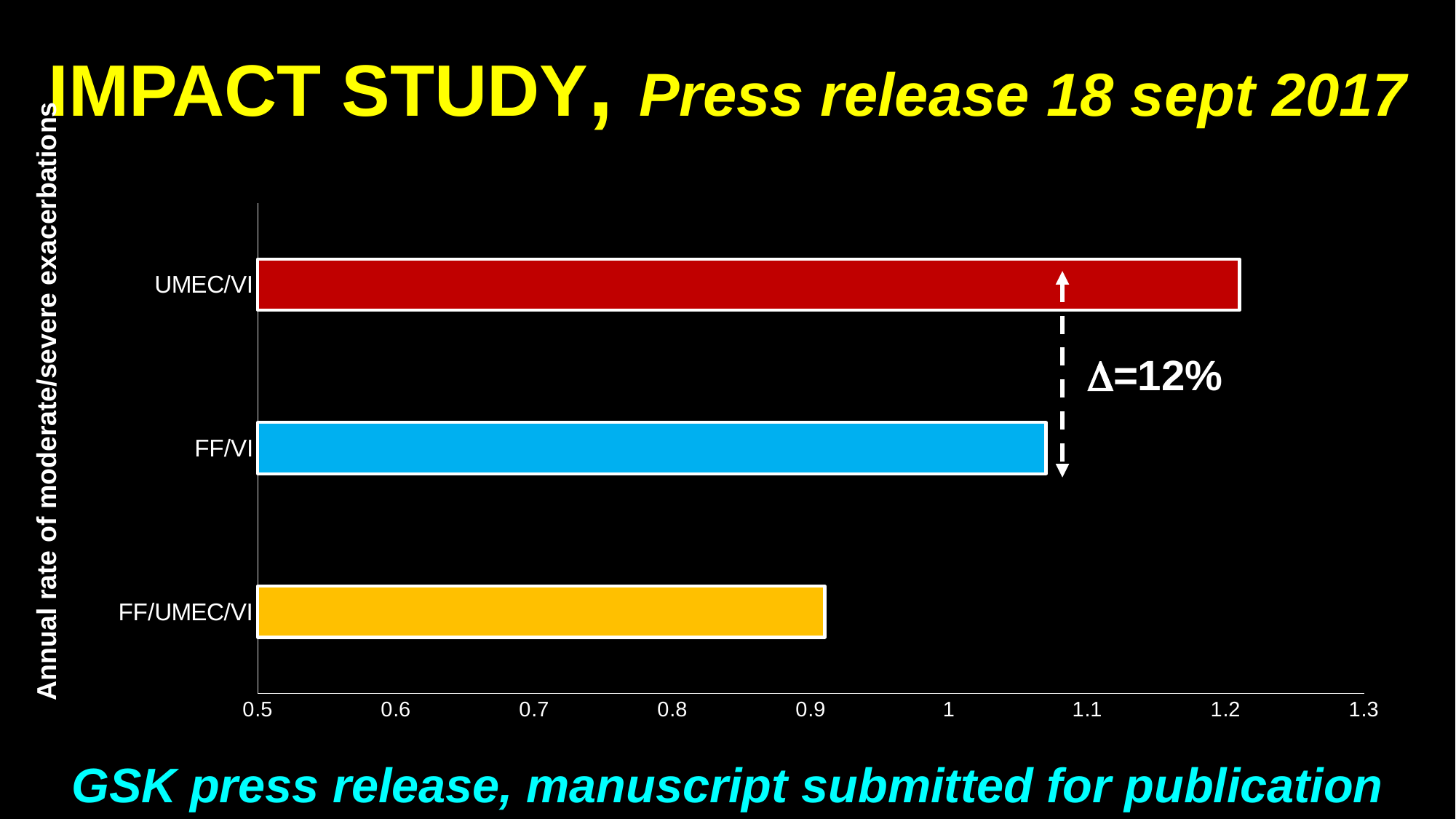
Is the value for FF/VI greater or less than 1.1? less Is the value for FF/UMEC/VI greater or less than 1? less Is the value for UMEC/VI greater or less than 1.1? greater Which has a lower value, FF/VI or FF/UMEC/VI? FF/UMEC/VI What is the label of the vertical axis of the chart? Annual rate of moderate/severe exacerbations How many categories (bars) are plotted in the chart? 3 Which category has the lowest annual rate of moderate/severe exacerbations? FF/UMEC/VI Which has a higher value, UMEC/VI or FF/VI? UMEC/VI What kind of chart is shown on the slide? bar chart What difference is annotated between the UMEC/VI and FF/VI bars? Δ=12% Which category has the highest annual rate of moderate/severe exacerbations? UMEC/VI